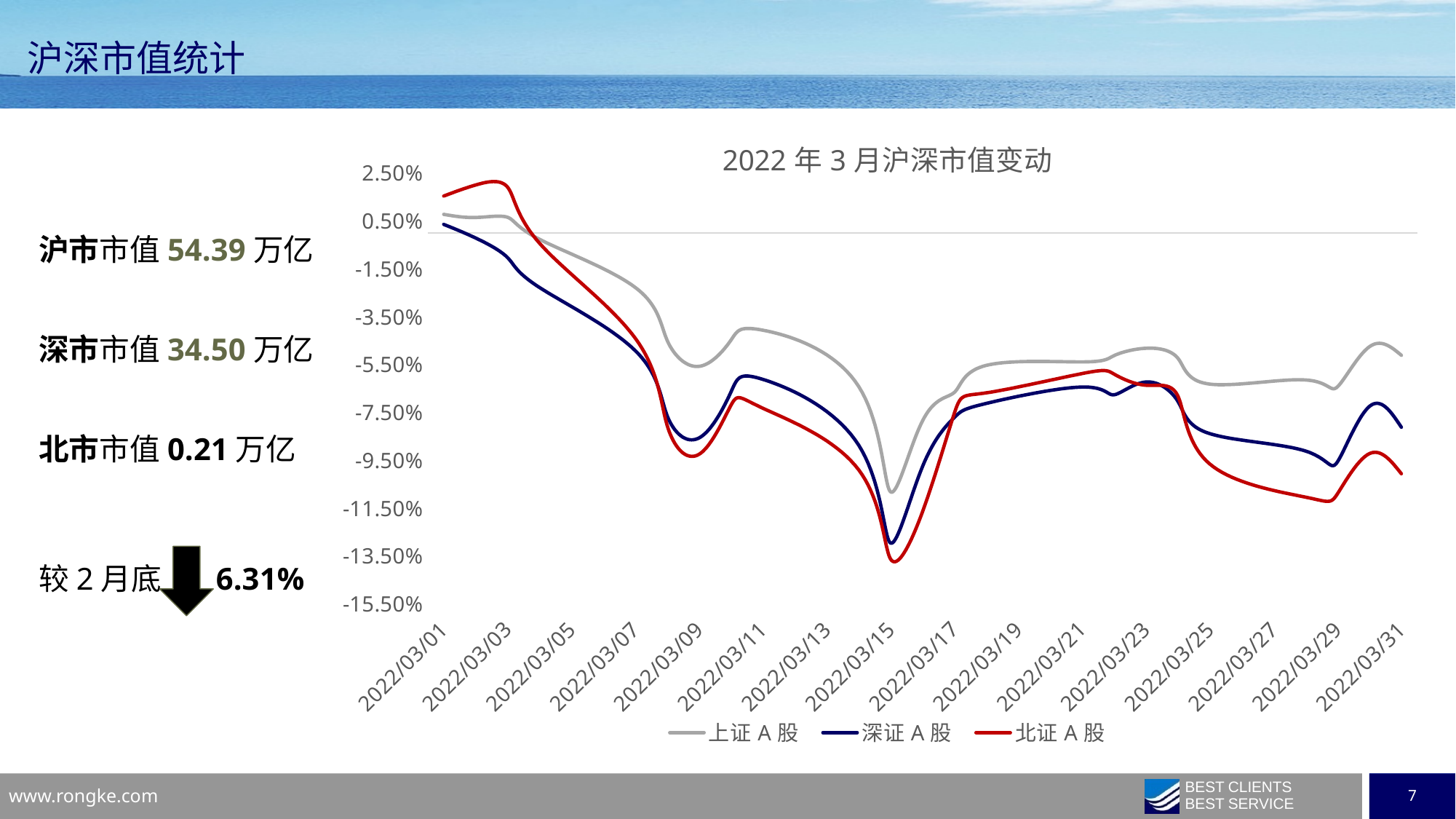
Is the value for 上证 A 股 at 2022/03/01 greater or less than 0.50%? greater Which series has the lowest value at 2022/03/15? 北证 A 股 How many series does the legend of the chart list? 3 Which series is drawn in red in the chart? 北证 A 股 What kind of chart is shown on the slide? line chart Is the value for 北证 A 股 at 2022/03/15 greater or less than -11.50%? less Which series has the highest value at 2022/03/31? 上证 A 股 Does the 上证 A 股 line rise or fall from 2022/03/01 to 2022/03/09? fall At 2022/03/29, which is higher: 上证 A 股 or 北证 A 股? 上证 A 股 How many date labels are shown on the x axis of the chart? 16 Is the value for 深证 A 股 at 2022/03/31 greater or less than -7.50%? less What is the title of the chart? 2022 年 3 月沪深市值变动